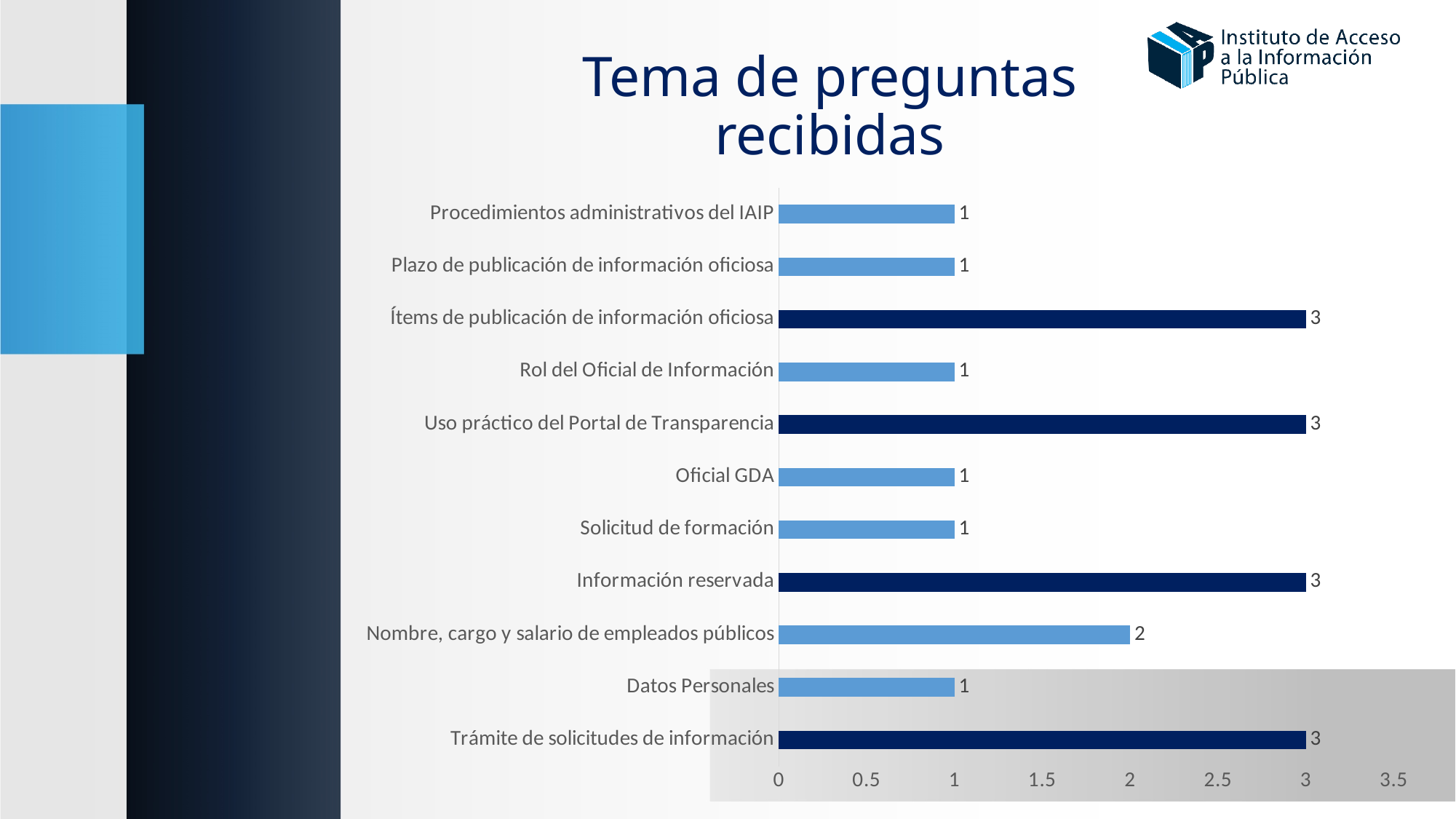
What is the title of the chart? Tema de preguntas recibidas How many categories are shown in the chart? 11 What is the value for "Oficial GDA"? 1 What is the difference between the values for "Información reservada" and "Nombre, cargo y salario de empleados públicos"? 1 What kind of chart is shown on the slide? Bar chart What is the value for "Nombre, cargo y salario de empleados públicos"? 2 Is the value for "Ítems de publicación de información oficiosa" greater or less than 2? greater What is the difference between the values for "Uso práctico del Portal de Transparencia" and "Datos Personales"? 2 What is the value for "Trámite de solicitudes de información"? 3 What is the highest value shown on the x axis? 3.5 What is the value for "Información reservada"? 3 Which is larger, the value for "Nombre, cargo y salario de empleados públicos" or the value for "Rol del Oficial de Información"? Nombre, cargo y salario de empleados públicos